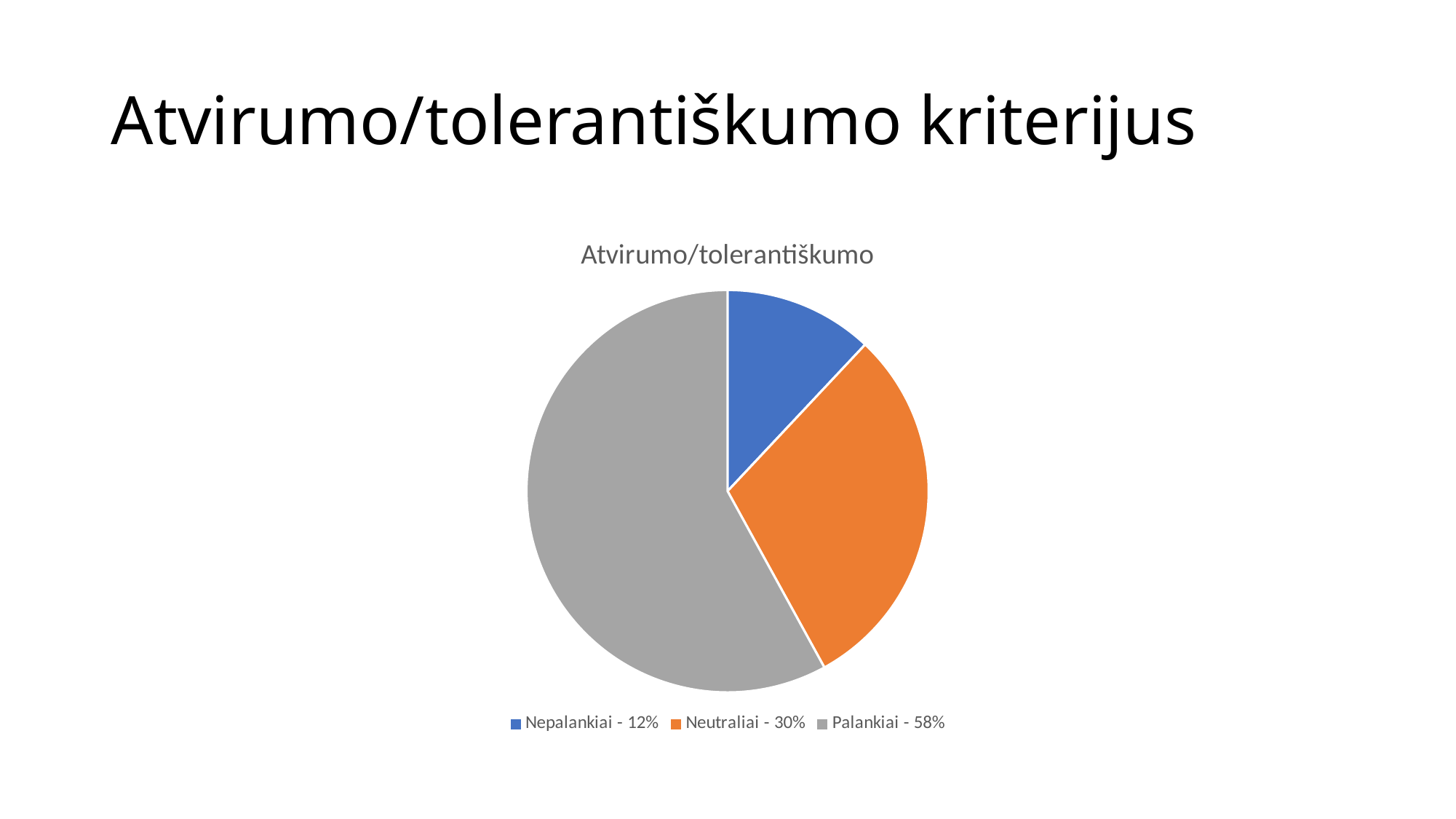
What colour is the Palankiai slice? grey What is the difference between the Neutraliai and Nepalankiai shares? 18% What share of the pie does Palankiai represent? 58% What is the title of the chart? Atvirumo/tolerantiškumo Which category has the largest slice? Palankiai What kind of chart is shown on the slide? pie chart What share of the pie does Neutraliai represent? 30% What share of the pie does Nepalankiai represent? 12% How many slices does the pie chart have? 3 What is the difference between the Palankiai and Neutraliai shares? 28% Which category has the smallest slice? Nepalankiai Which is larger, the Neutraliai slice or the Nepalankiai slice? Neutraliai